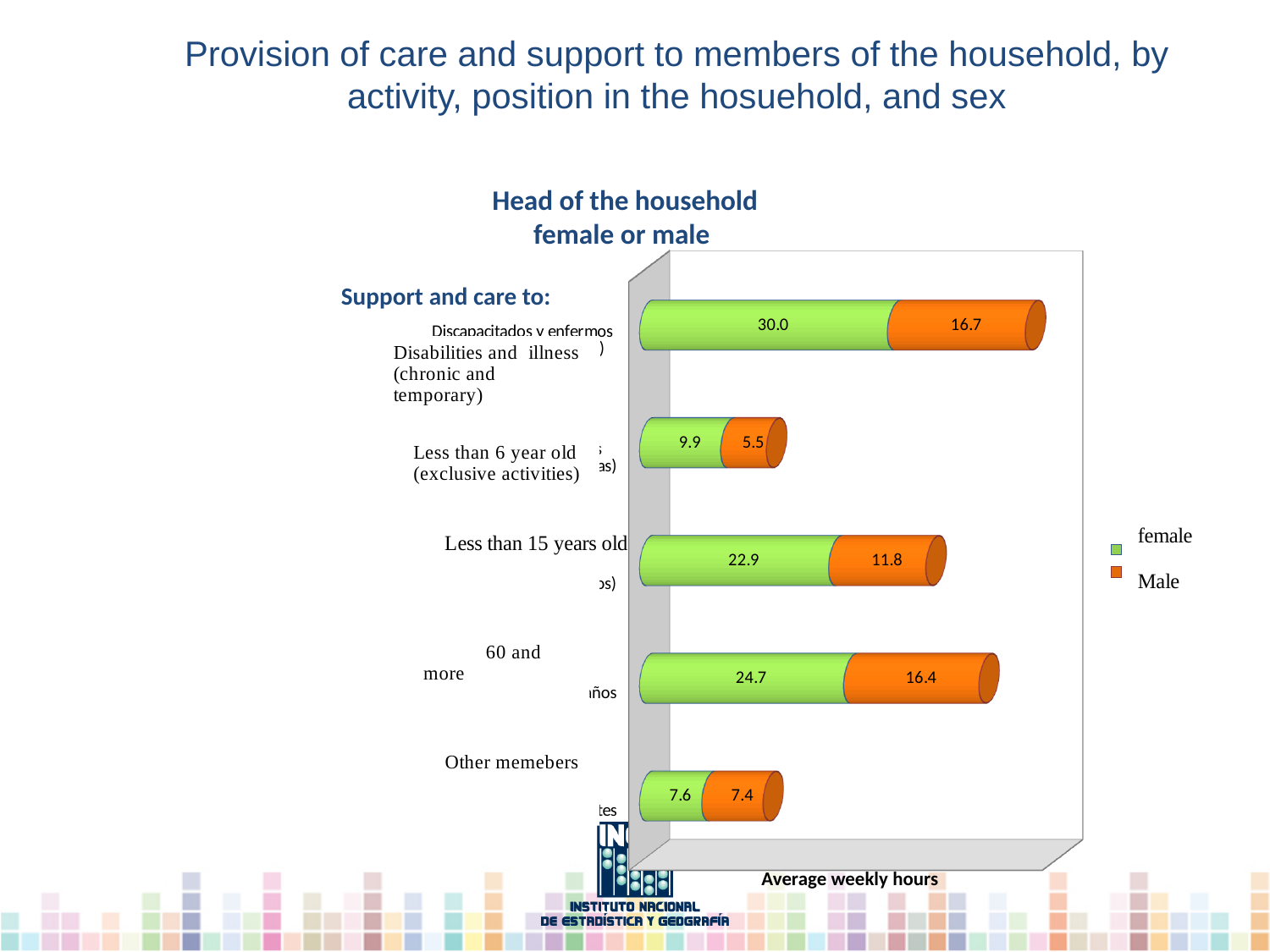
What is the female value for Disabilities and illness (chronic and temporary)? 30.0 Which is larger, the female value for 60 and more or the female value for Less than 15 years old? 60 and more What is the female value for 60 and more? 24.7 How many series does the legend list? 2 Which category has the lowest Male value? Less than 6 year old (exclusive activities) What is the Male value for Other members? 7.4 What is the difference between the female and Male values for Less than 6 year old (exclusive activities)? 4.4 Which category has the highest female value? Disabilities and illness (chronic and temporary) How many categories are shown in the chart? 5 What is the total of the stacked bar for Disabilities and illness (chronic and temporary)? 46.7 What is the Male value for Less than 15 years old? 11.8 What kind of chart is shown on the slide? Stacked bar chart